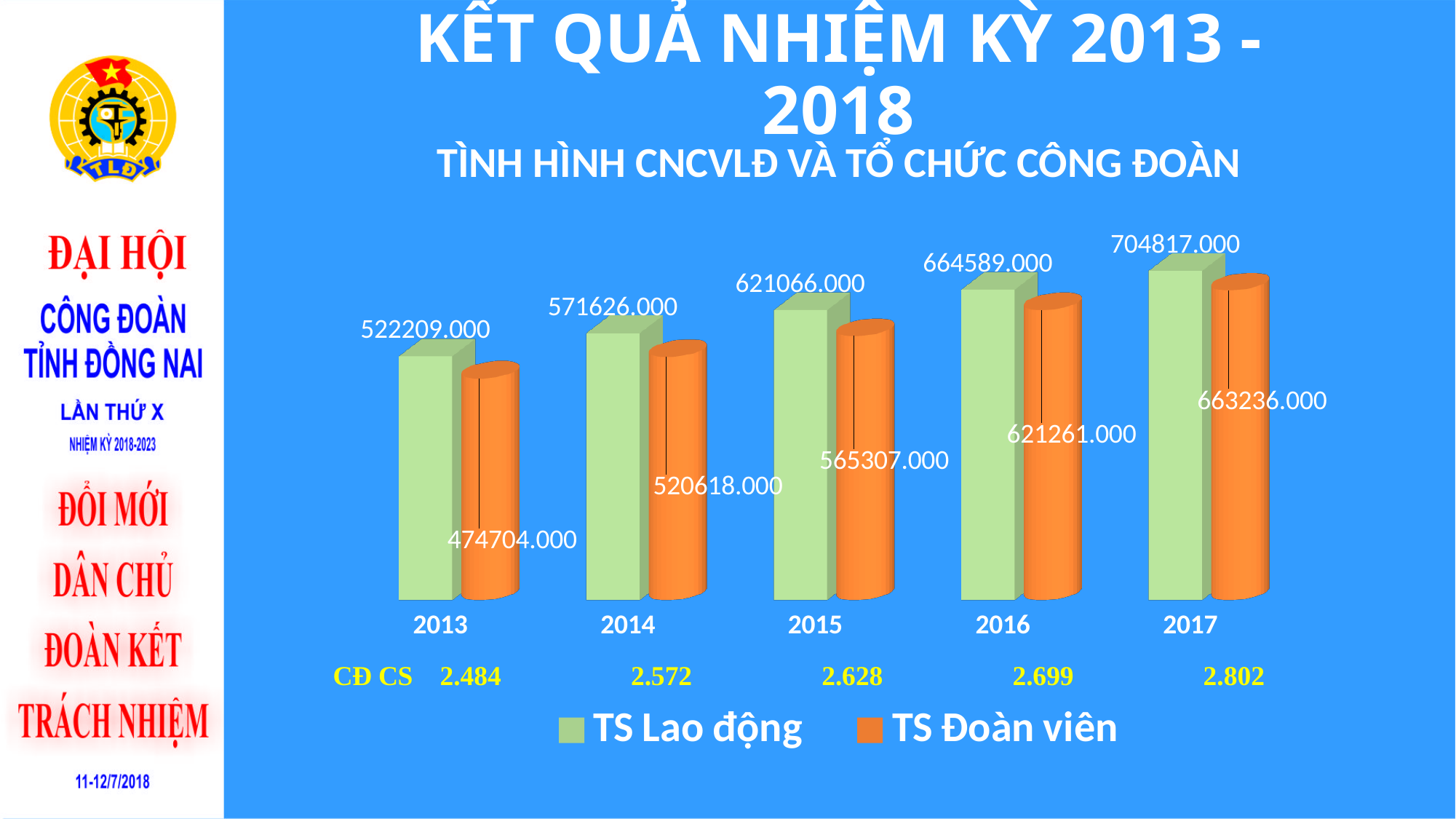
In which year is TS Lao động highest? 2017 Which is larger in 2015: TS Lao động or TS Đoàn viên? TS Lao động What is the value of TS Đoàn viên for 2013? 474704.000 In which year is TS Đoàn viên lowest? 2013 What kind of chart is shown on the slide? Bar chart How many years are shown on the x axis of the chart? 5 What is the value of TS Lao động for 2015? 621066.000 Does TS Đoàn viên rise or fall from 2013 to 2017? Rise What is the difference between TS Lao động and TS Đoàn viên in 2017? 41581.000 How many series does the legend list? 2 What is the value of TS Lao động for 2014? 571626.000 What is the value of TS Đoàn viên for 2016? 621261.000